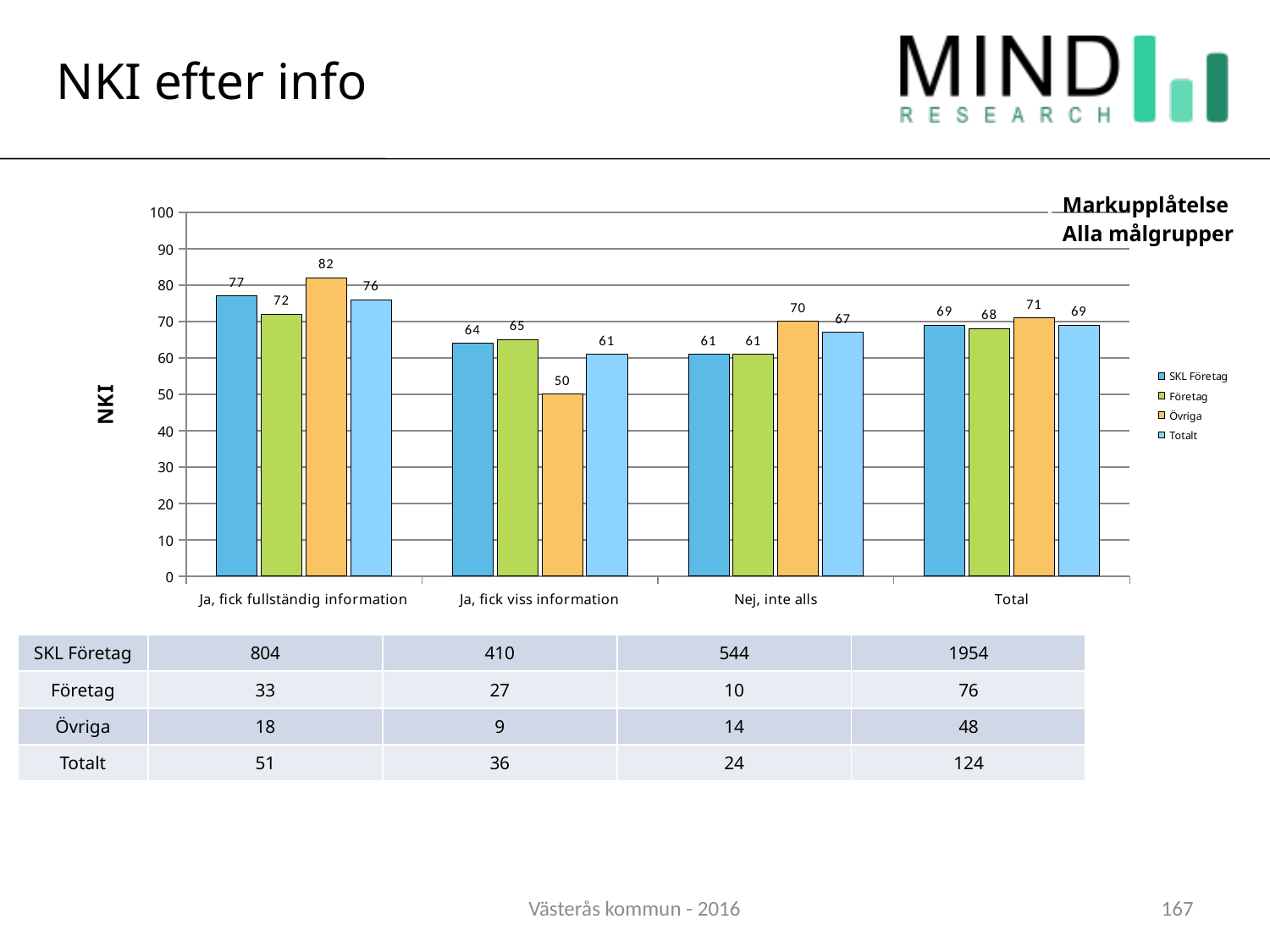
What is the NKI value for Övriga in the 'Ja, fick viss information' category? 50 What is the NKI value for Totalt in the 'Nej, inte alls' category? 67 What is the difference between the SKL Företag value for 'Ja, fick fullständig information' and for 'Nej, inte alls'? 16 How many series does the legend list? 4 What is the NKI value for Övriga in the 'Ja, fick fullständig information' category? 82 Which series has the lowest NKI value in the 'Ja, fick viss information' category? Övriga Which series has the highest NKI value in the 'Ja, fick fullständig information' category? Övriga What kind of chart is shown on the slide? bar chart How many categories are shown on the x axis of the chart? 4 What is the label of the y axis of the chart? NKI Is the Övriga value for 'Nej, inte alls' greater or less than 60? greater Which is larger: the Företag value for 'Ja, fick fullständig information' or the Företag value for 'Nej, inte alls'? Ja, fick fullständig information